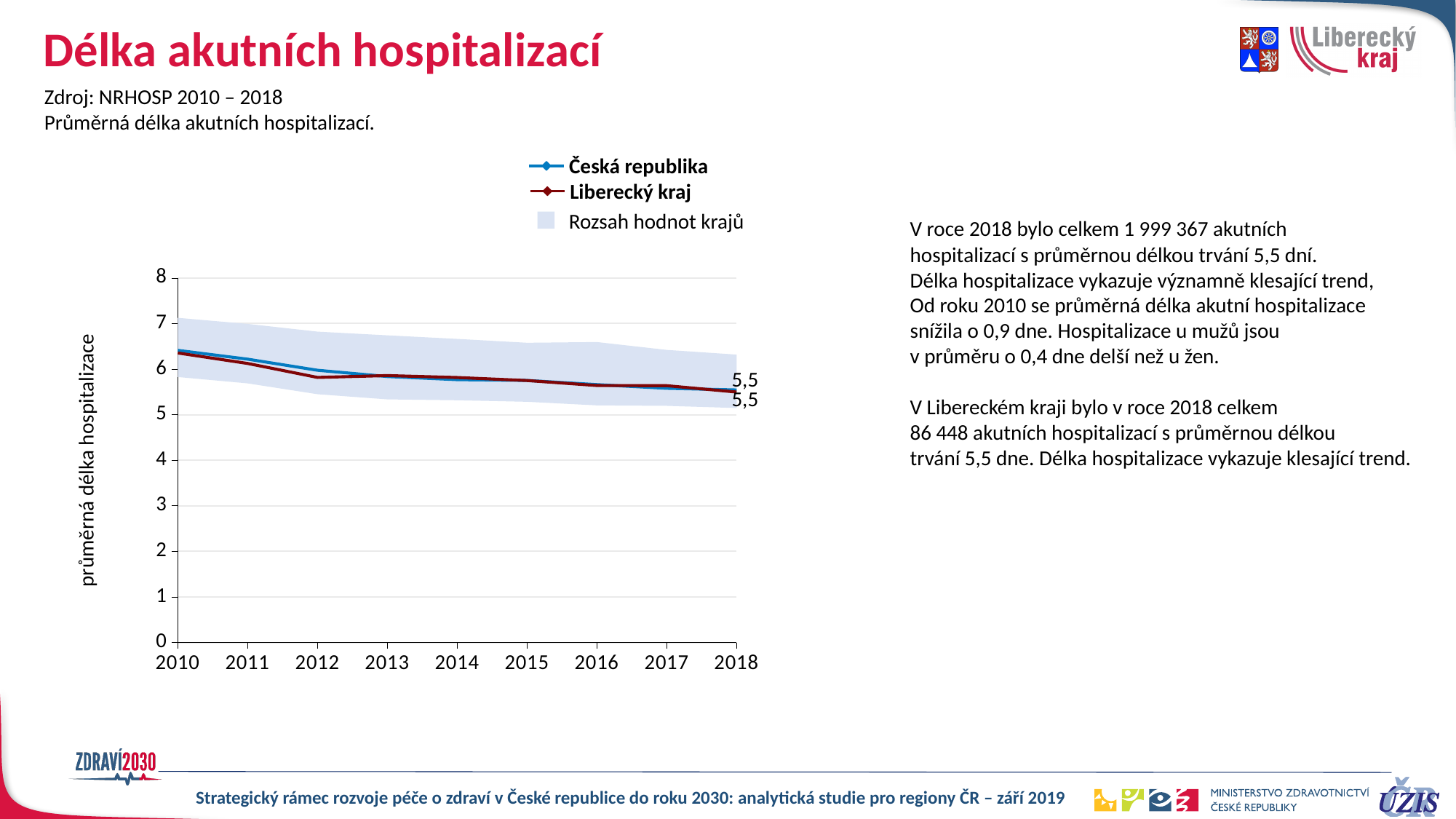
Is the value for Liberecký kraj in 2012 greater or less than 6? less Do the values for Česká republika rise or fall from 2010 to 2018? fall In which year is the value for Česká republika highest? 2010 What is the value for Česká republika in 2018? 5,5 What is the label of the y axis? průměrná délka hospitalizace What kind of chart is shown on the slide? line chart How many entries does the legend list? 3 Is the value for Česká republika in 2010 greater or less than 6? greater How many years are plotted on the x axis? 9 In 2012, which series has the larger value, Česká republika or Liberecký kraj? Česká republika What is the value for Liberecký kraj in 2018? 5,5 In which year is the value for Liberecký kraj lowest? 2018